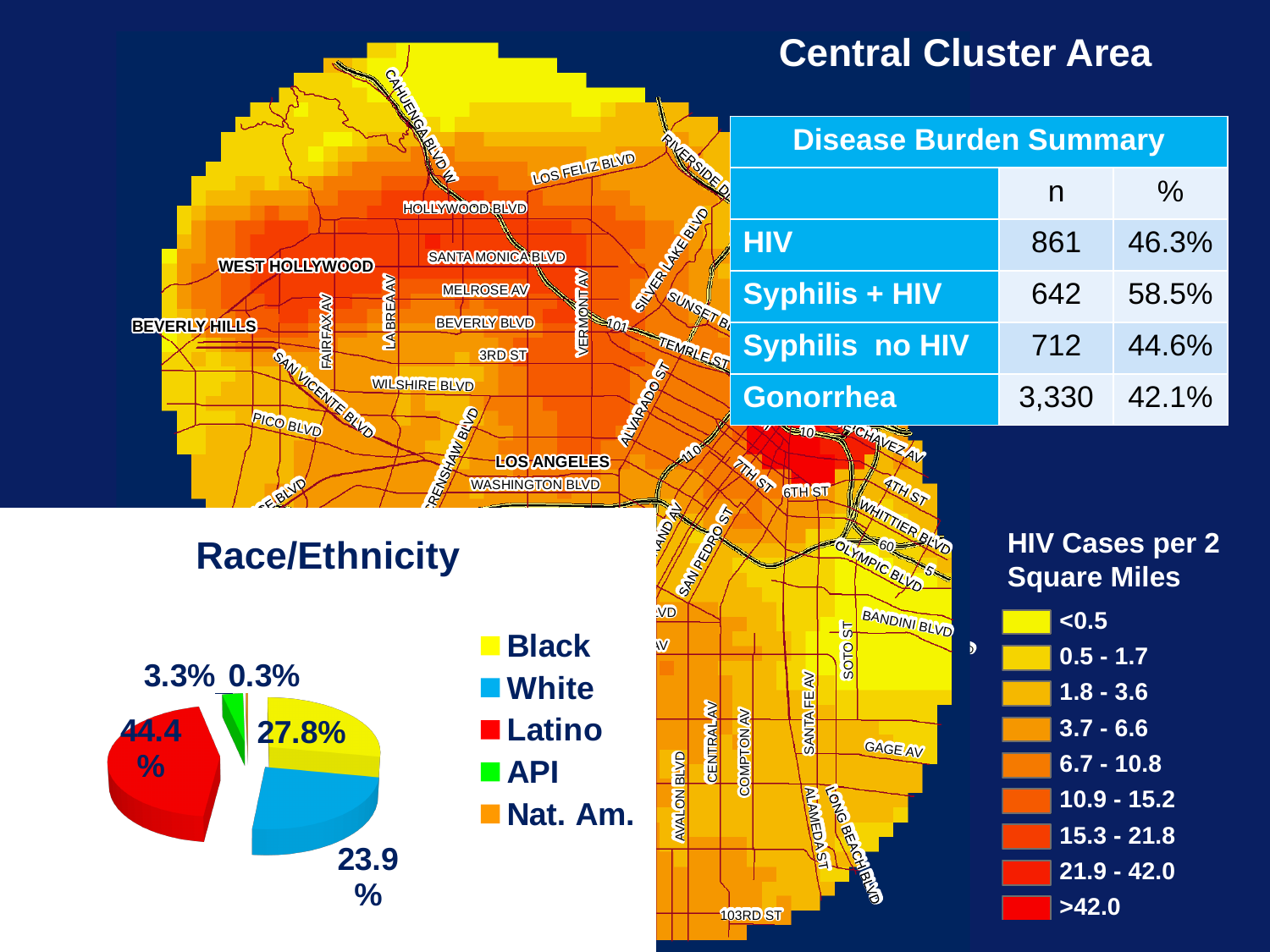
In the Race/Ethnicity pie chart, what is the difference between the Latino and Black shares? 16.6% How many groups does the legend of the Race/Ethnicity pie chart list? 5 In the Race/Ethnicity pie chart, what colour represents Latino? red In the Race/Ethnicity pie chart, what share is White? 23.9% In the Race/Ethnicity pie chart, what share is API? 3.3% In the Race/Ethnicity pie chart, what share is Nat. Am.? 0.3% In the Race/Ethnicity pie chart, what share is Latino? 44.4% In the Race/Ethnicity pie chart, which group has the smallest share? Nat. Am. What kind of chart is the Race/Ethnicity chart? pie chart In the Race/Ethnicity pie chart, which group has the largest share? Latino In the Race/Ethnicity pie chart, which is larger, the Black share or the White share? Black In the Race/Ethnicity pie chart, what share is Black? 27.8%